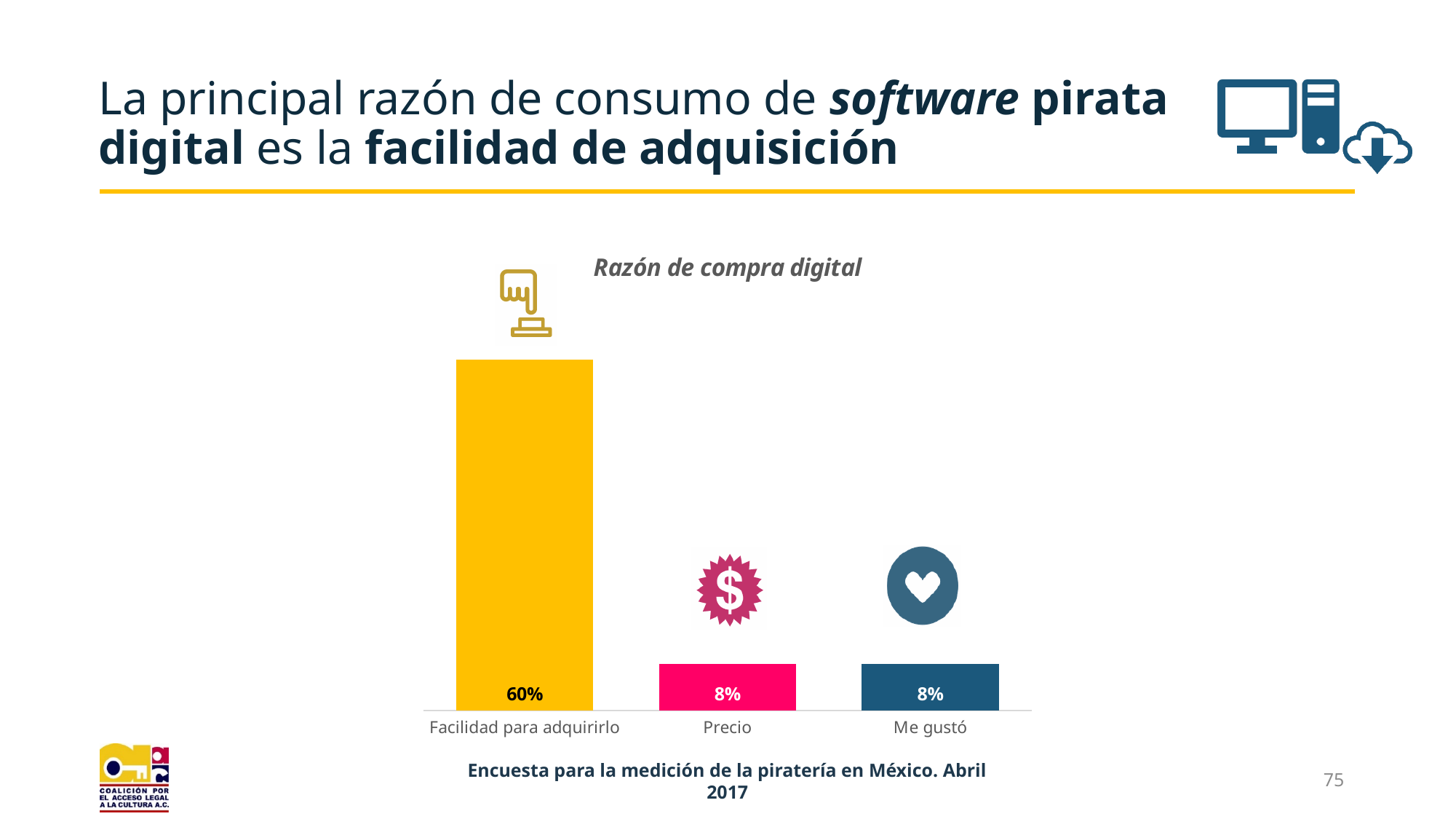
What is the value for Precio? 8% How many categories are shown in the chart? 3 What is the title of the chart? Razón de compra digital Which category has the highest value? Facilidad para adquirirlo What kind of chart is shown on the slide? Bar chart What is the value for Me gustó? 8% Which is larger, the value for Facilidad para adquirirlo or the value for Me gustó? Facilidad para adquirirlo What is the value for Facilidad para adquirirlo? 60% What colour is the bar for Facilidad para adquirirlo? Yellow What is the difference between the values for Facilidad para adquirirlo and Precio? 52% Do the values for Precio and Me gustó differ? No, both are 8%